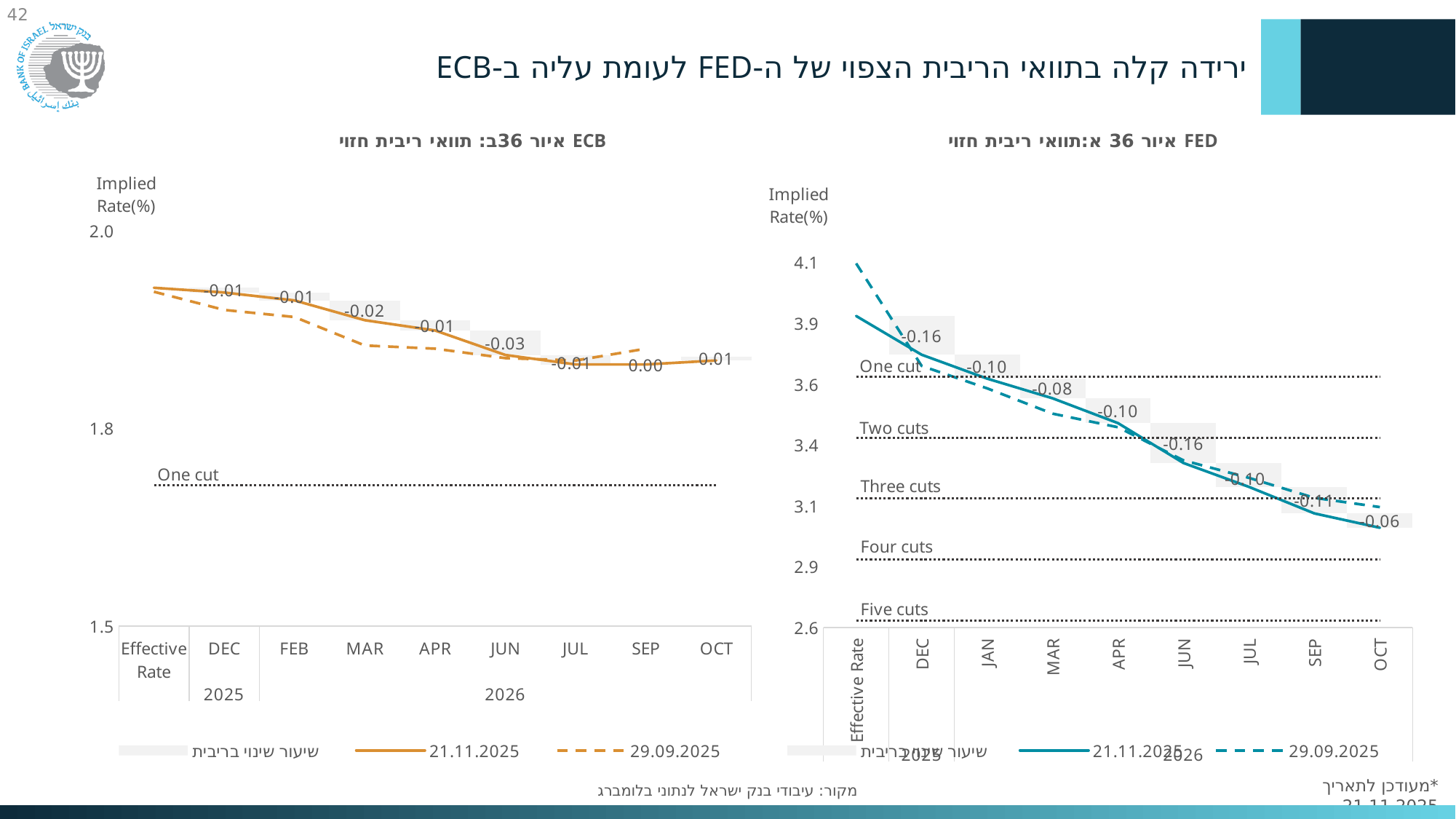
In the FED chart (איור 36א), is the 21.11.2025 implied rate at OCT greater or less than 3.1? less In the FED chart (איור 36א), what is the rate change label shown at OCT? -0.06 In the FED chart (איור 36א), does the 21.11.2025 implied rate rise or fall from Effective Rate to OCT? fall In the FED chart (איור 36א), what is the rate change label shown at DEC? -0.16 In the ECB chart (איור 36ב), what is the rate change label shown at JUN? -0.03 In the ECB chart (איור 36ב), at which month is the rate change label lowest? JUN In the FED chart (איור 36א), which rate change label is larger: the one at DEC or the one at MAR? MAR What kind of chart is the FED chart (איור 36א) on the right of the slide? combination bar and line chart How many series does the legend of the ECB chart (איור 36ב) list? 3 In the ECB chart (איור 36ב), what is the rate change label shown at SEP? 0.00 In the FED chart (איור 36א), at which month is the rate change label highest (least negative)? OCT How many categories are shown on the x axis of the ECB chart (איור 36ב)? 9